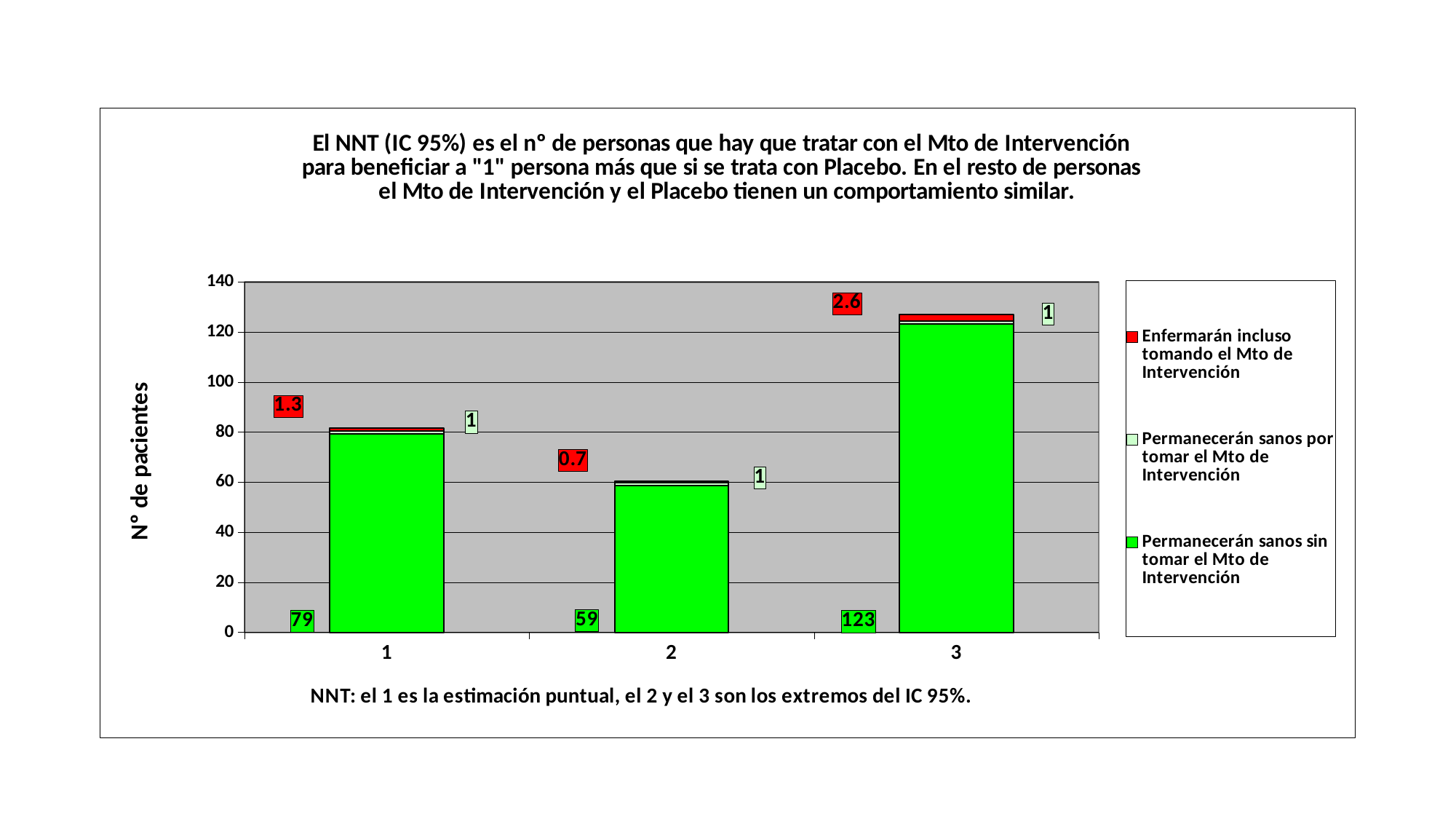
Which category has the lowest value for 'Enfermarán incluso tomando el Mto de Intervención'? 2 What is the value of 'Permanecerán sanos sin tomar el Mto de Intervención' for category 1? 79 How many series does the legend list? 3 What is the value of 'Permanecerán sanos por tomar el Mto de Intervención' for category 3? 1 Which category has the highest value for 'Permanecerán sanos sin tomar el Mto de Intervención'? 3 What kind of chart is shown on the slide? Stacked bar chart What is the total of the stacked bar for category 2? 60.7 Is the 'Enfermarán incluso tomando el Mto de Intervención' value larger for category 1 or category 3? 3 How many categories are shown on the x axis? 3 What is the value of 'Enfermarán incluso tomando el Mto de Intervención' for category 2? 0.7 What is the difference between the 'Permanecerán sanos sin tomar el Mto de Intervención' values for category 3 and category 1? 44 What is the value of 'Permanecerán sanos sin tomar el Mto de Intervención' for category 3? 123